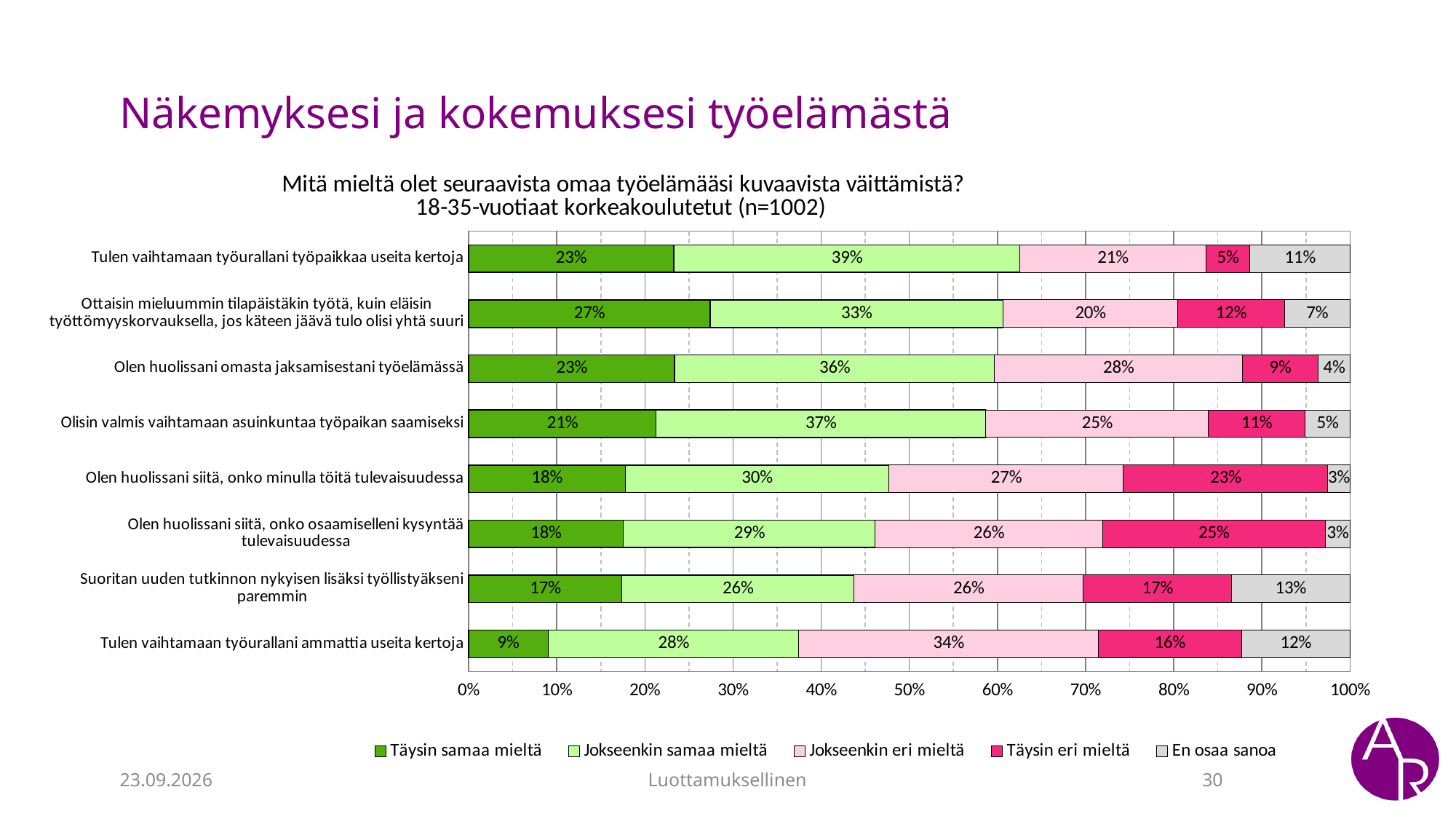
Which statement has the lowest 'Täysin samaa mieltä' value? Tulen vaihtamaan työurallani ammattia useita kertoja (9%) Which statement has the highest 'Täysin samaa mieltä' value? Ottaisin mieluummin tilapäistäkin työtä, kuin eläisin työttömyyskorvauksella, jos käteen jäävä tulo olisi yhtä suuri (27%) What is the 'Täysin eri mieltä' value for 'Olen huolissani siitä, onko osaamiselleni kysyntää tulevaisuudessa'? 25% What is the difference in 'En osaa sanoa' between 'Suoritan uuden tutkinnon nykyisen lisäksi työllistyäkseni paremmin' and 'Olen huolissani omasta jaksamisestani työelämässä'? 9 percentage points Which statement has the highest 'Jokseenkin samaa mieltä' value? Tulen vaihtamaan työurallani työpaikkaa useita kertoja (39%) Which has the larger 'Täysin eri mieltä' value: 'Olen huolissani siitä, onko minulla töitä tulevaisuudessa' or 'Suoritan uuden tutkinnon nykyisen lisäksi työllistyäkseni paremmin'? Olen huolissani siitä, onko minulla töitä tulevaisuudessa How many series does the legend list? 5 What is the combined share of 'Täysin samaa mieltä' and 'Jokseenkin samaa mieltä' for 'Tulen vaihtamaan työurallani työpaikkaa useita kertoja'? 62% How many statements (categories) are plotted in the chart? 8 What is the 'Täysin samaa mieltä' value for 'Tulen vaihtamaan työurallani ammattia useita kertoja'? 9% What is the 'En osaa sanoa' value for 'Suoritan uuden tutkinnon nykyisen lisäksi työllistyäkseni paremmin'? 13% What kind of chart is shown on the slide? Stacked bar chart